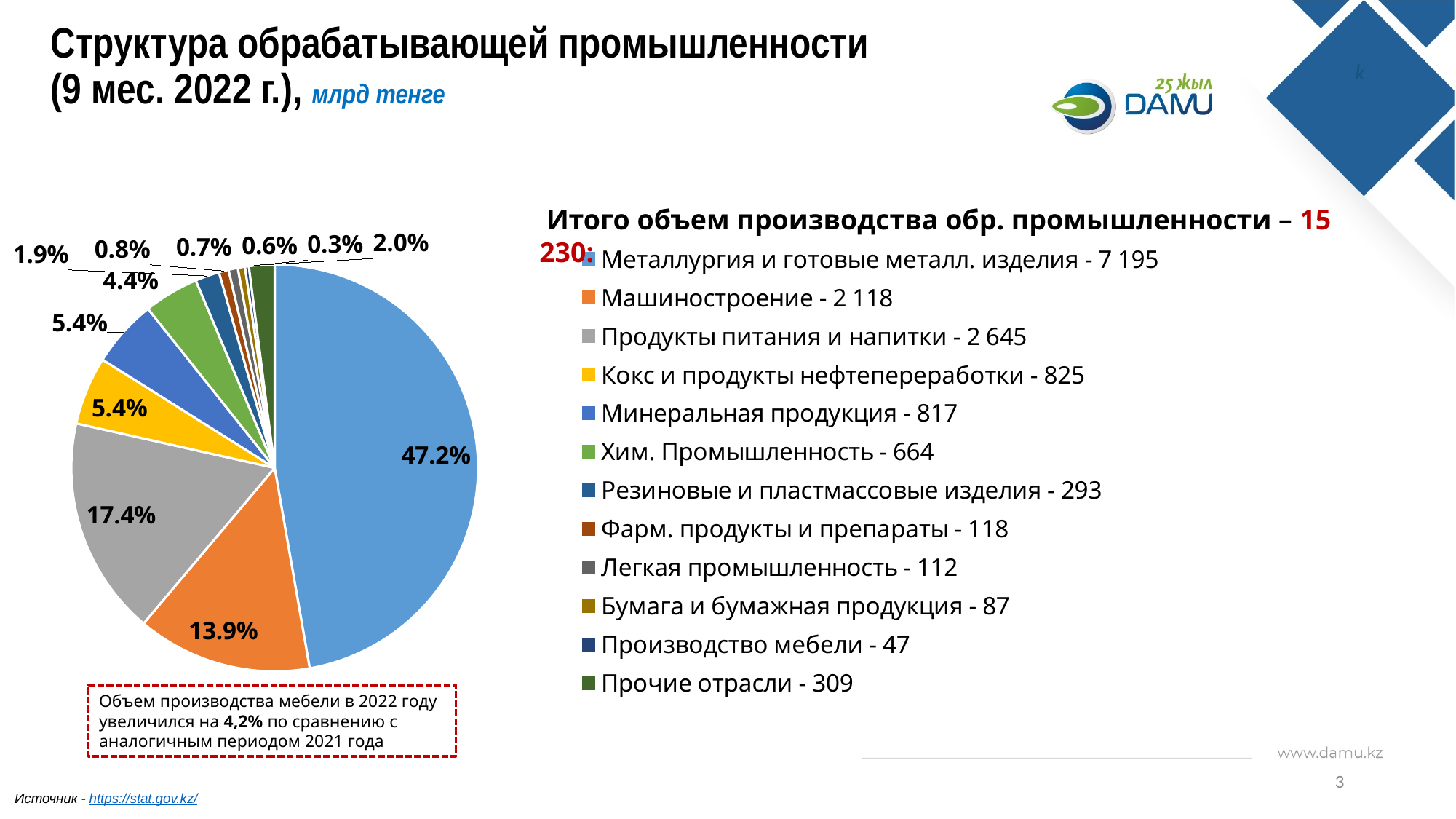
Which is larger: the slice for Машиностроение or the slice for Продукты питания и напитки? Продукты питания и напитки How many categories does the pie chart have? 12 What percentage is shown for Машиностроение? 13.9% What share of the pie does Металлургия и готовые металл. изделия hold? 47.2% What percentage is shown for Продукты питания и напитки? 17.4% What percentage is shown for Хим. Промышленность? 4.4% According to the legend, what is the production value for Кокс и продукты нефтепереработки? 825 Which category has the largest slice of the pie? Металлургия и готовые металл. изделия What kind of chart is shown on the slide? pie chart What total volume of manufacturing production is stated on the slide? 15 230 Which category has the smallest slice of the pie? Производство мебели What is the difference in percentage points between the Металлургия и готовые металл. изделия slice and the Продукты питания и напитки slice? 29.8%